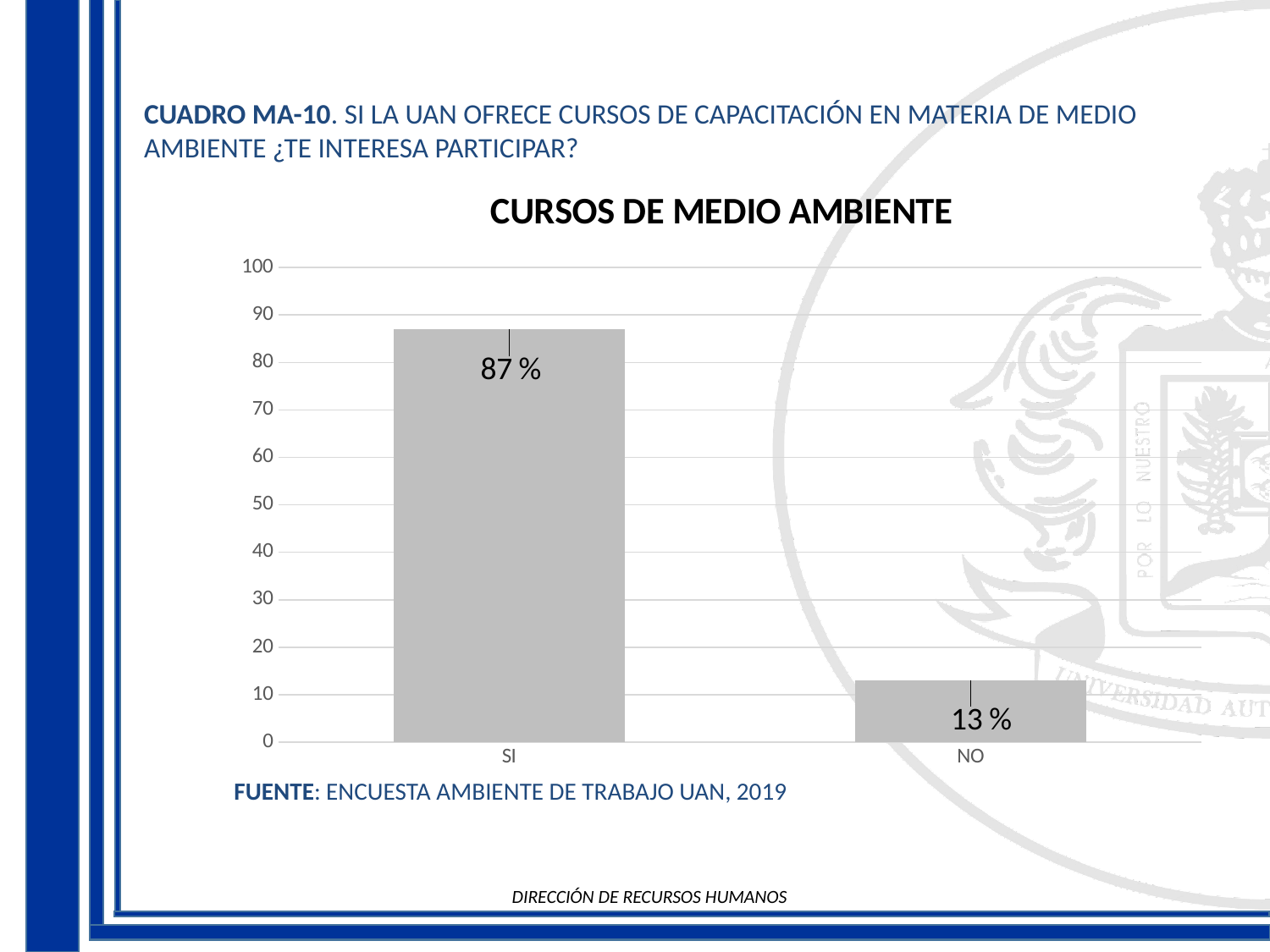
What kind of chart is shown on the slide? bar chart How many categories are shown on the x axis? 2 What is the difference between the values for SI and NO? 74 % Which category has the lowest value? NO Which is larger, the value for SI or the value for NO? SI What is the highest value shown on the y axis? 100 What is the value for NO in the chart? 13 % Is the value for SI greater or less than 80? greater What is the value for SI in the chart? 87 % Which category has the highest value? SI What is the title of the chart? CURSOS DE MEDIO AMBIENTE Is the value for NO greater or less than 20? less